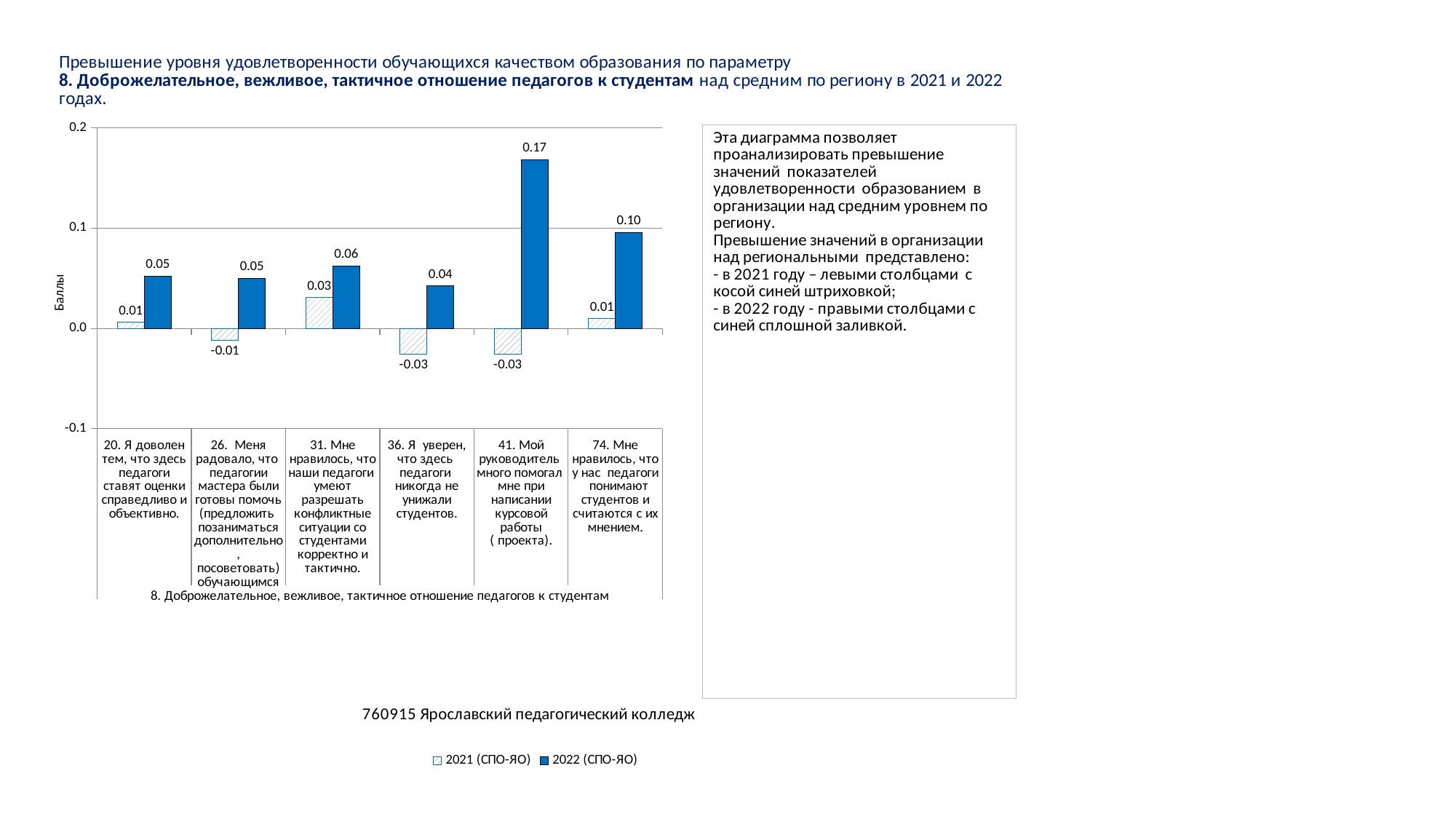
What is the 2021 (СПО-ЯО) value for statement 36 (Я уверен, что здесь педагоги никогда не унижали студентов)? -0.03 How many series does the legend list? 2 Which statement has the highest 2021 (СПО-ЯО) value? 31. Мне нравилось, что наши педагоги умеют разрешать конфликтные ситуации со студентами корректно и тактично. What is the 2022 (СПО-ЯО) value for statement 41 (Мой руководитель много помогал мне при написании курсовой работы)? 0.17 Is the 2022 (СПО-ЯО) value for statement 41 greater or less than 0.1? greater What type of chart is shown on the slide? bar chart How many categories (statements) are plotted on the x axis? 6 Which statement has the highest 2022 (СПО-ЯО) value? 41. Мой руководитель много помогал мне при написании курсовой работы (проекта). What is the 2022 (СПО-ЯО) value for statement 74 (Мне нравилось, что у нас педагоги понимают студентов)? 0.10 What is the label of the vertical axis? Баллы Which is larger for statement 31: the 2021 (СПО-ЯО) value or the 2022 (СПО-ЯО) value? 2022 (СПО-ЯО) What is the difference between the 2022 and 2021 values for statement 41? 0.20